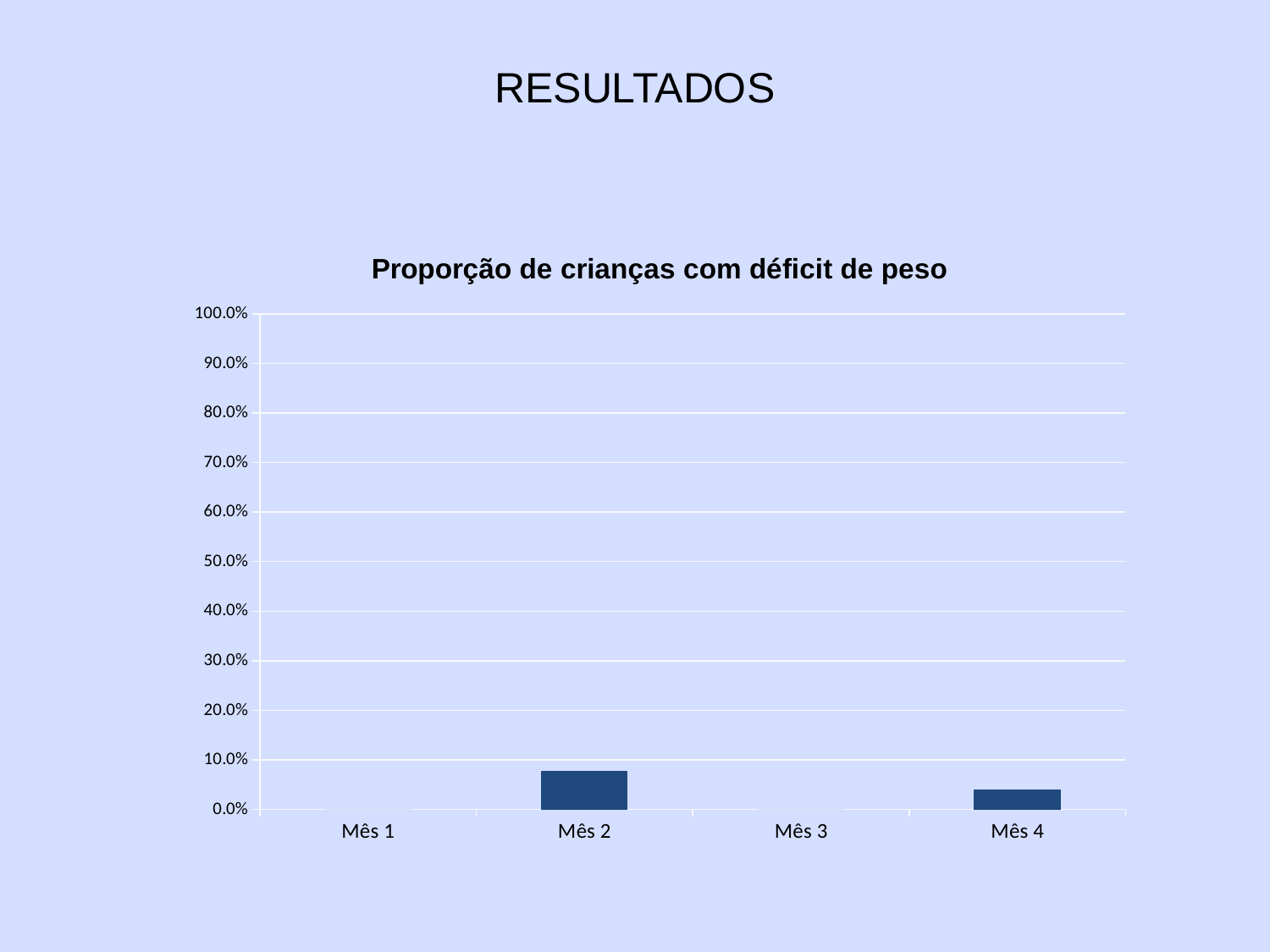
Which is larger, the value for Mês 2 or the value for Mês 4? Mês 2 Which month has the highest proportion of children with weight deficit? Mês 2 Is the value for Mês 2 greater or less than 50.0%? less What is the value shown for Mês 1? 0.0% What is the title of the chart? Proporção de crianças com déficit de peso Is the value for Mês 2 greater or less than 10.0%? less What kind of chart is shown on the slide? bar chart What is the value shown for Mês 3? 0.0% Is the value for Mês 4 greater or less than 10.0%? less How many categories are shown on the x axis of the chart? 4 What is the highest tick value shown on the y axis of the chart? 100.0%